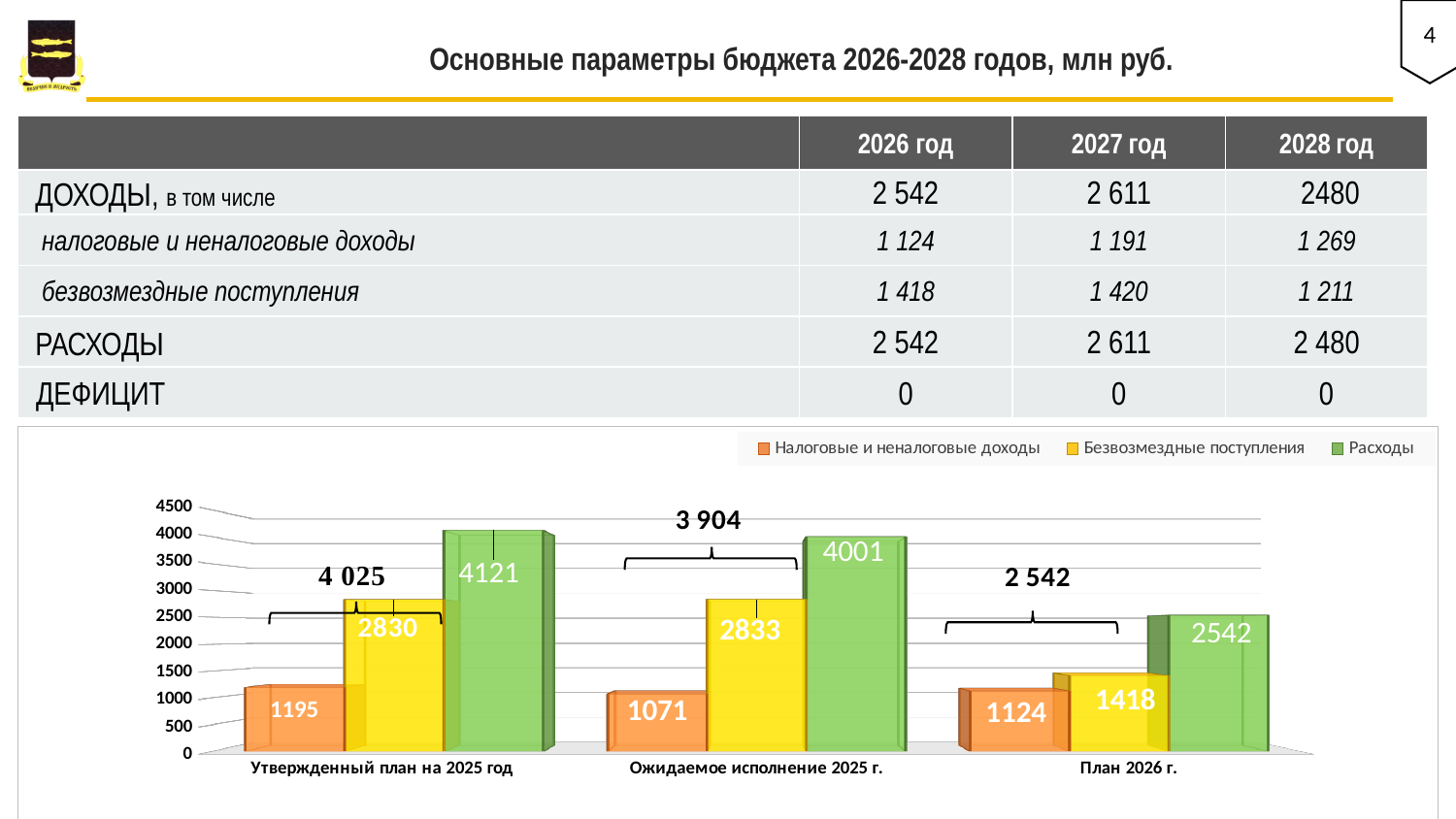
Does the value of Расходы for План 2026 г. fall along the x axis from the first category to the last? fall Which category has the lowest value for Безвозмездные поступления? План 2026 г. What is the value of Расходы for Утвержденный план на 2025 год? 4121 How many categories are shown on the x axis of the chart? 3 What is the value of Налоговые и неналоговые доходы for План 2026 г.? 1124 How many series does the chart legend list? 3 What is the difference between Расходы for Ожидаемое исполнение 2025 г. and Расходы for План 2026 г.? 1459 Which category has the highest value for Расходы? Утвержденный план на 2025 год What kind of chart is shown at the bottom of the slide? bar chart What is the value of Безвозмездные поступления for Ожидаемое исполнение 2025 г.? 2833 What total is shown above the bracket for Ожидаемое исполнение 2025 г.? 3 904 Which is larger: Налоговые и неналоговые доходы for Утвержденный план на 2025 год or for Ожидаемое исполнение 2025 г.? Утвержденный план на 2025 год